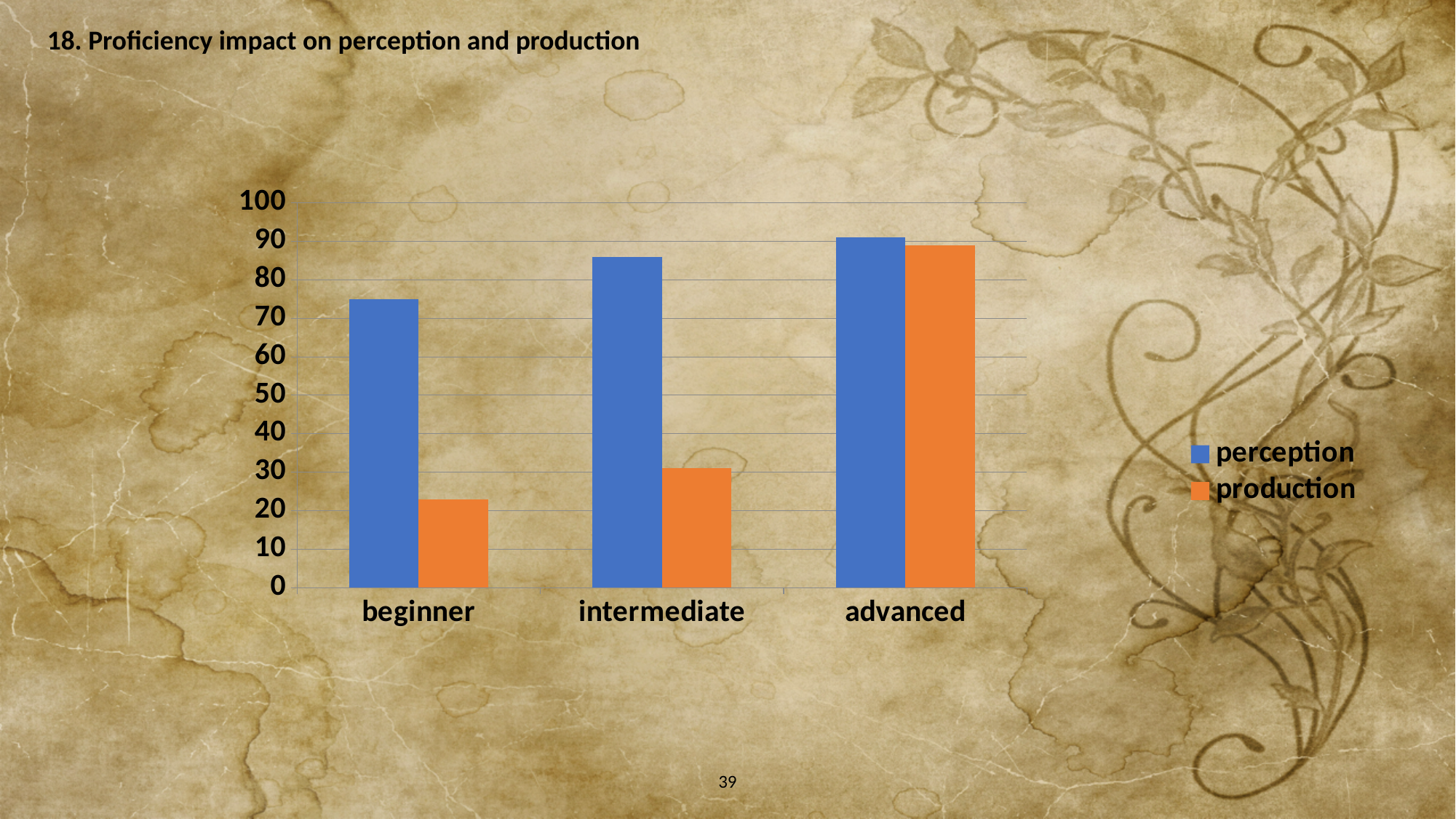
For the intermediate level, which is larger: perception or production? perception Is the perception value for beginner greater or less than 70? greater How many proficiency categories are shown on the x axis? 3 Which proficiency level has the lowest production value? beginner Is the perception value for intermediate greater or less than 80? greater Which proficiency level has the highest perception value? advanced Is the production value for beginner greater or less than 30? less How many series does the legend list? 2 Which colour represents the production series? orange Do the production values rise or fall from beginner to advanced? rise What kind of chart is shown on the slide? bar chart